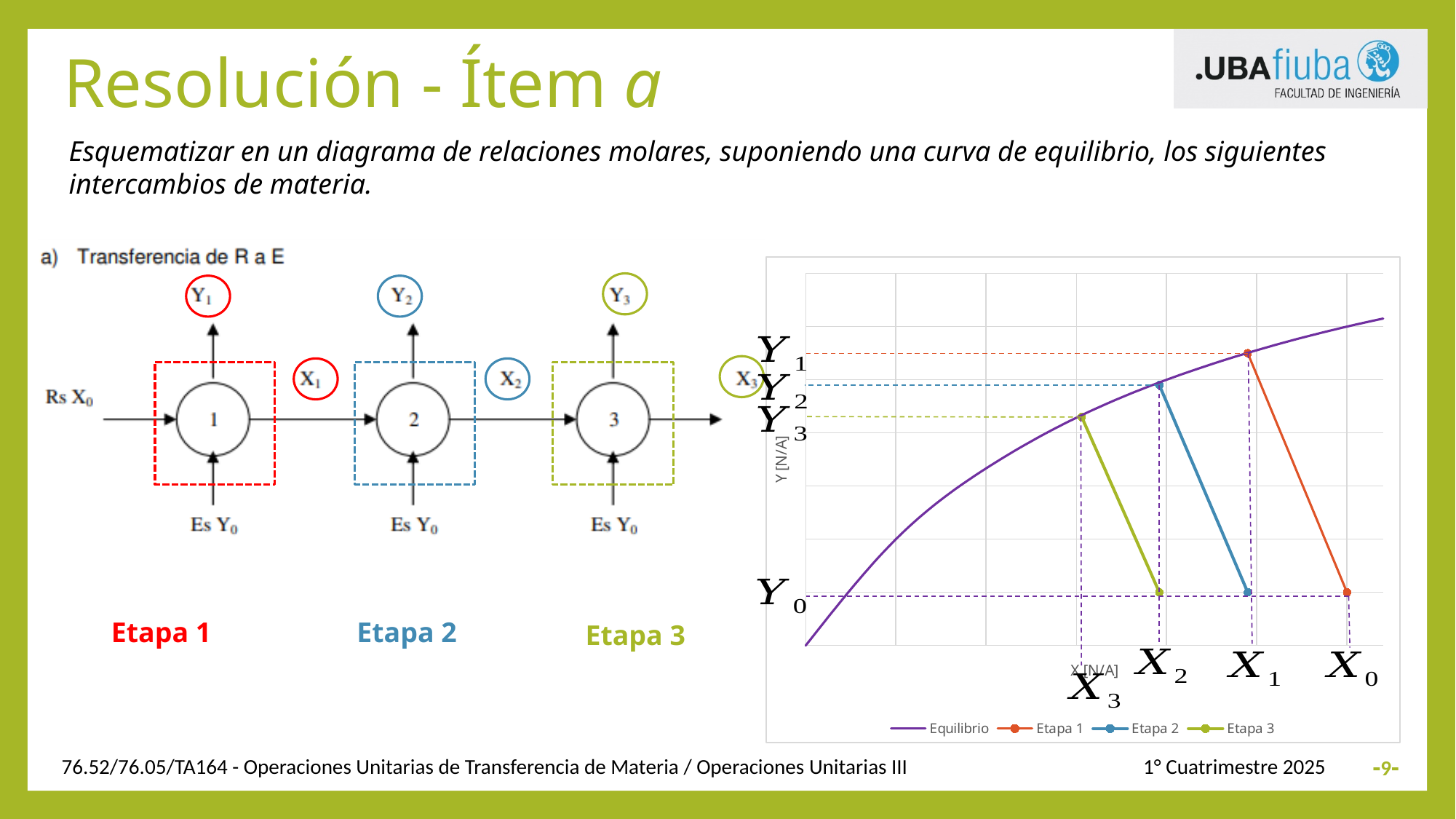
Which stage line reaches the lowest point on the equilibrium curve? Etapa 3 Which stage line is located furthest to the right on the chart? Etapa 1 Which is larger on the chart, Y2 or Y0? Y2 What is the label of the vertical axis of the chart? Y [N/A] Does the Equilibrio curve rise or fall as X increases? rise Which stage line reaches the highest point on the equilibrium curve? Etapa 1 What kind of chart is shown on the right of the slide? line chart Which is larger on the chart, Y1 or Y3? Y1 How many stage (Etapa) lines are plotted on the chart? 3 What are the series names listed in the chart legend? Equilibrio, Etapa 1, Etapa 2, Etapa 3 How many series does the legend of the chart list? 4 Which is larger on the chart, X0 or X3? X0